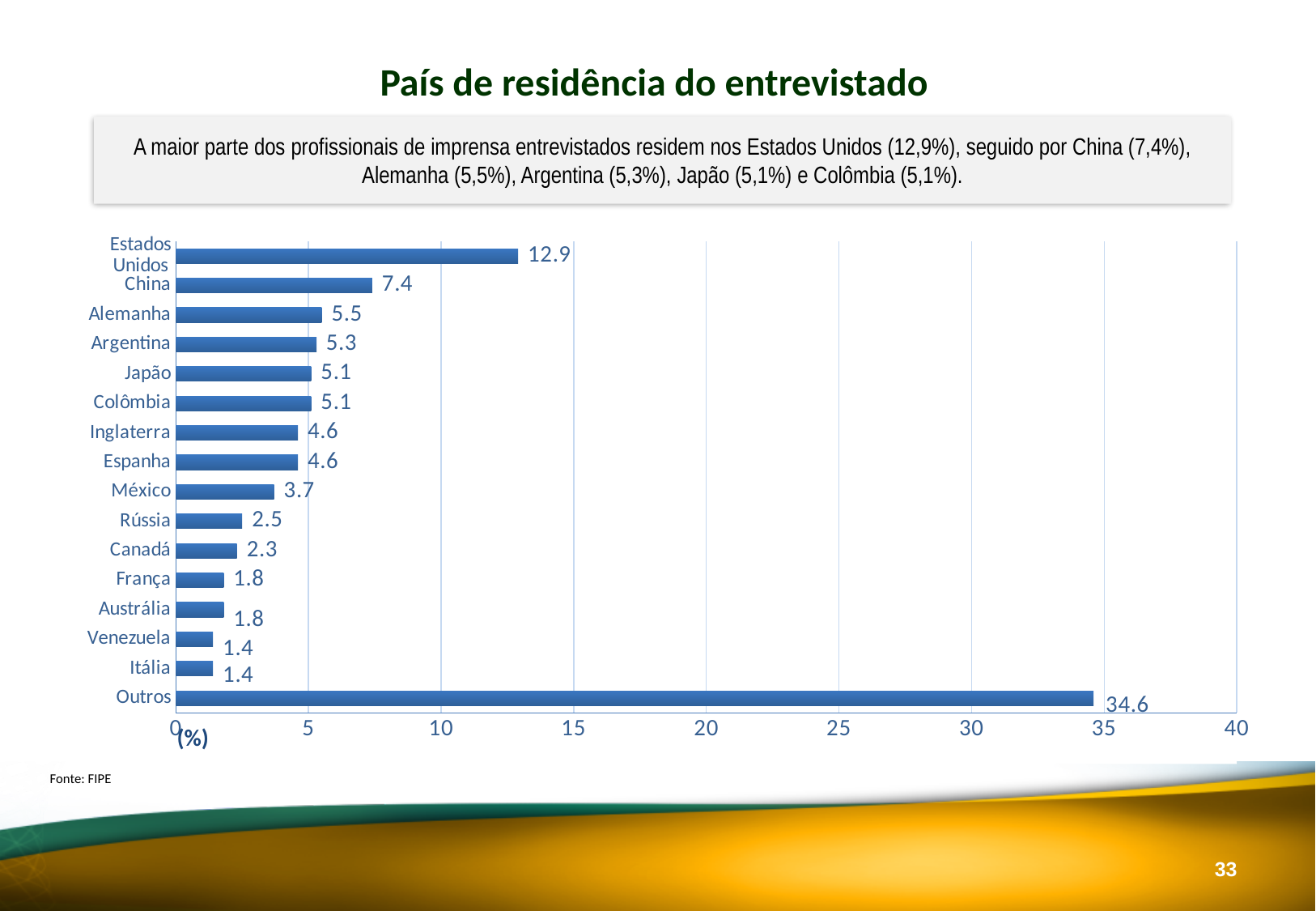
How many categories are shown in the chart? 16 What is the value for Outros? 34.6 What is the value for China? 7.4 What is the value for Estados Unidos? 12.9 What type of chart is shown on the slide? bar chart Which category has the highest value? Outros What is the difference between the values for Outros and Estados Unidos? 21.7 Is the value for Outros greater or less than 30? greater Which country (excluding Outros) has the highest value? Estados Unidos Which is larger, the value for Rússia or the value for Canadá? Rússia What is the value for México? 3.7 What is the difference between the values for Estados Unidos and China? 5.5